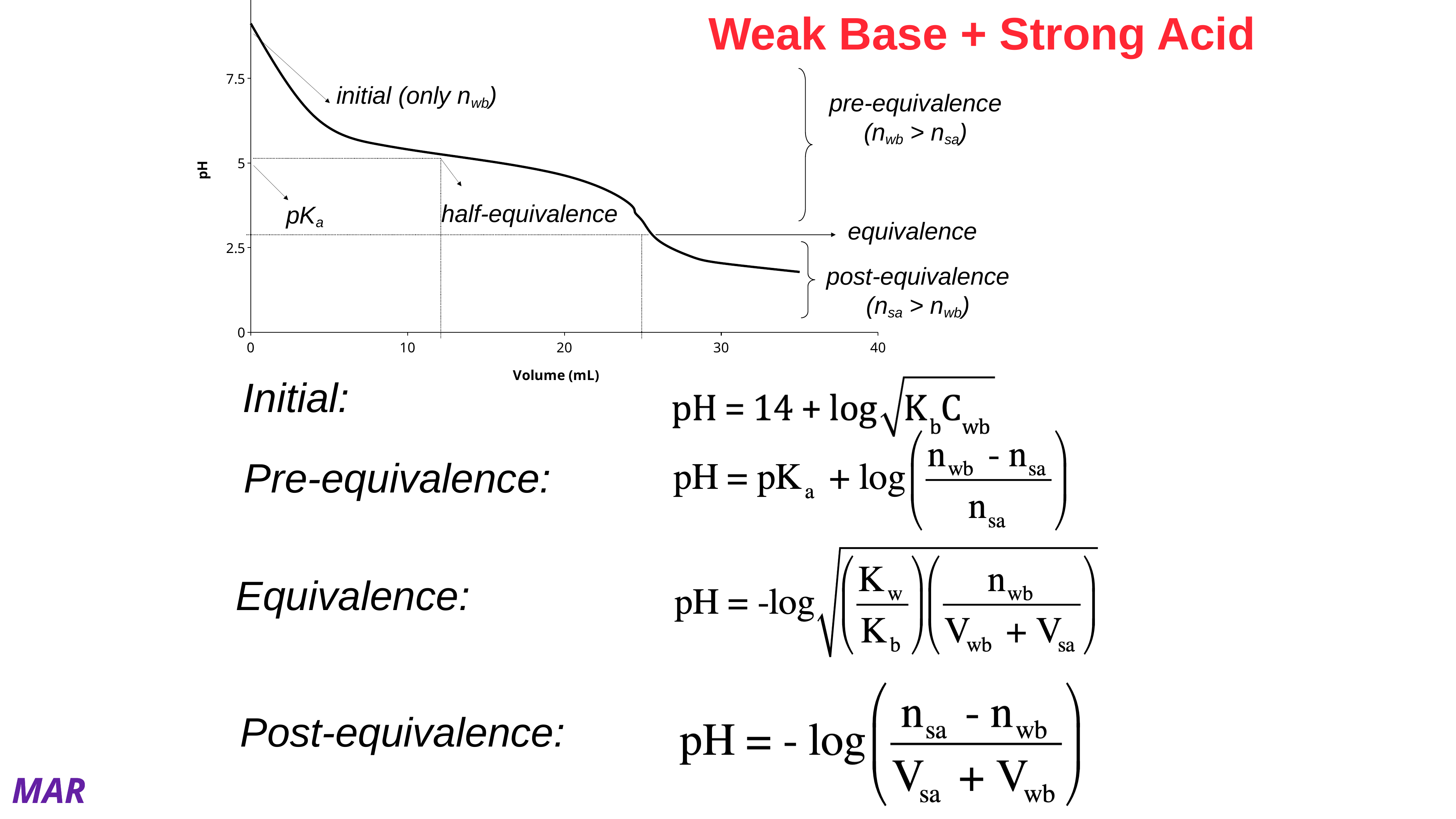
Is the volume at the half-equivalence point greater or less than 10 mL? greater Is the pH at 20 mL greater or less than 7.5? less What is the title of the slide containing the chart? Weak Base + Strong Acid Is the pH at 10 mL greater or less than 5? greater What kind of chart is shown on the slide? line chart What is the largest value shown on the x axis of the chart? 40 Does the pH rise or fall as the volume increases along the x axis? fall What is the label of the x axis of the chart? Volume (mL)